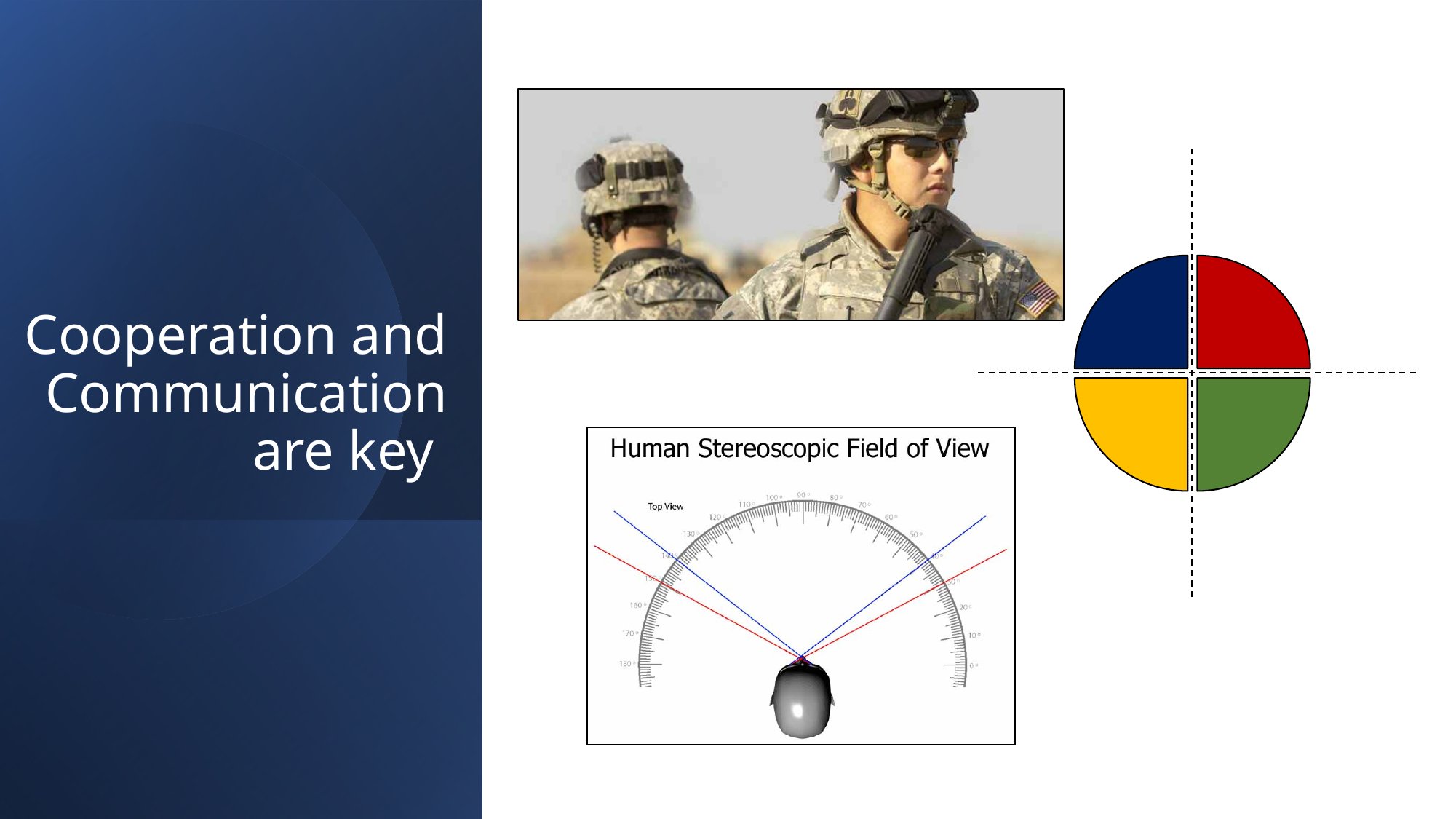
What colour is the top-right slice of the pie chart on the right side of the slide? red In the Human Stereoscopic Field of View diagram, what is the largest angle marked on the protractor scale? 180° What is the title of the diagram at the bottom centre of the slide? Human Stereoscopic Field of View What kind of chart is the four-coloured circle on the right side of the slide? pie chart How many slices does the pie chart on the right side of the slide have? 4